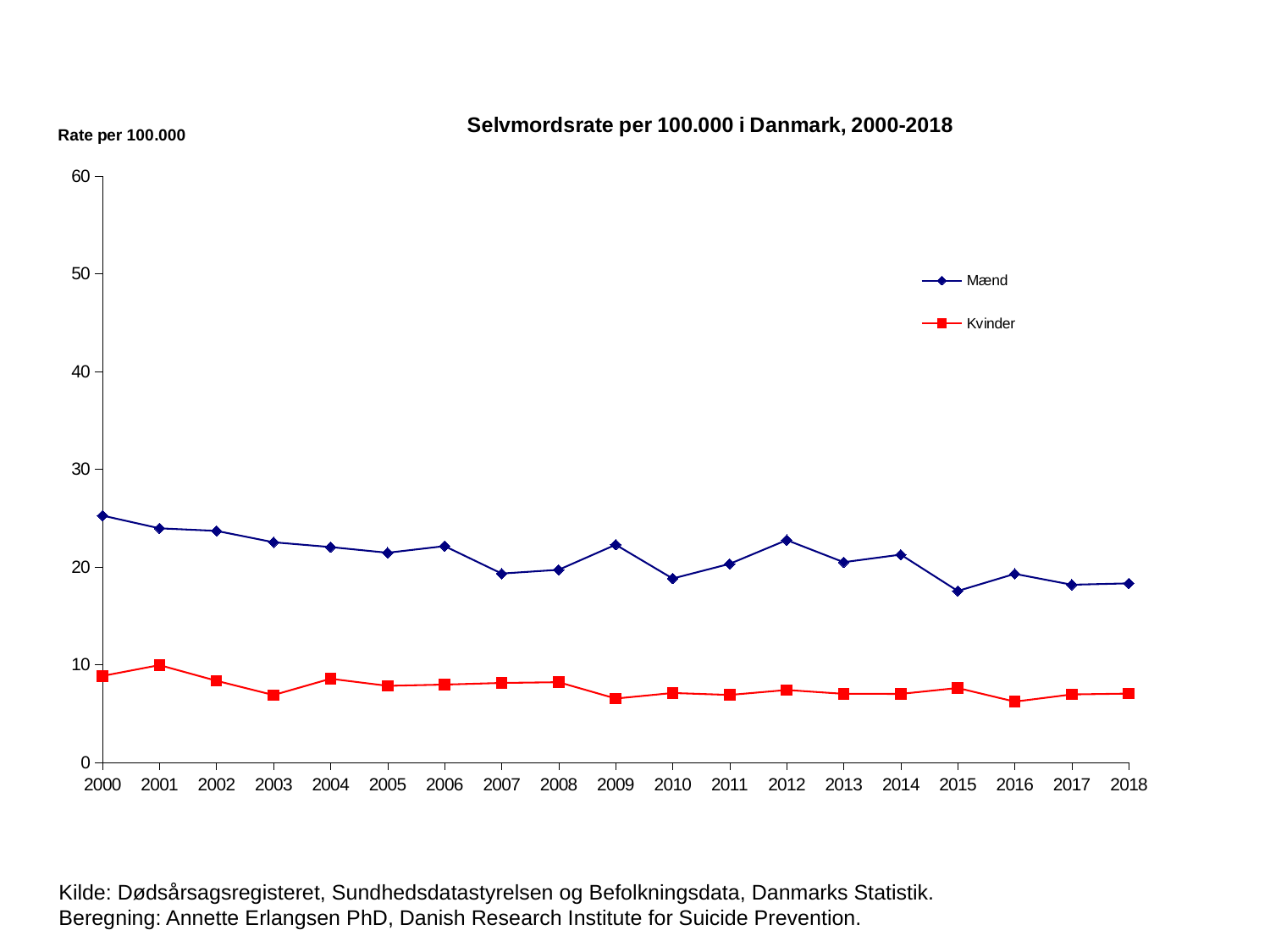
How many years are plotted along the x axis? 19 In which year is the Kvinder series at its highest? 2001 Which series has the larger value in 2010, Mænd or Kvinder? Mænd In which year is the Mænd series at its highest? 2000 Is the value for Kvinder in 2003 greater or less than 10? less Is the value for Mænd in 2000 greater or less than 20? greater What is the title of the chart? Selvmordsrate per 100.000 i Danmark, 2000-2018 What kind of chart is shown on the slide? line chart Is the value for Mænd in 2012 greater or less than 20? greater How many series does the legend list? 2 Does the Mænd series generally rise or fall from 2000 to 2018? fall